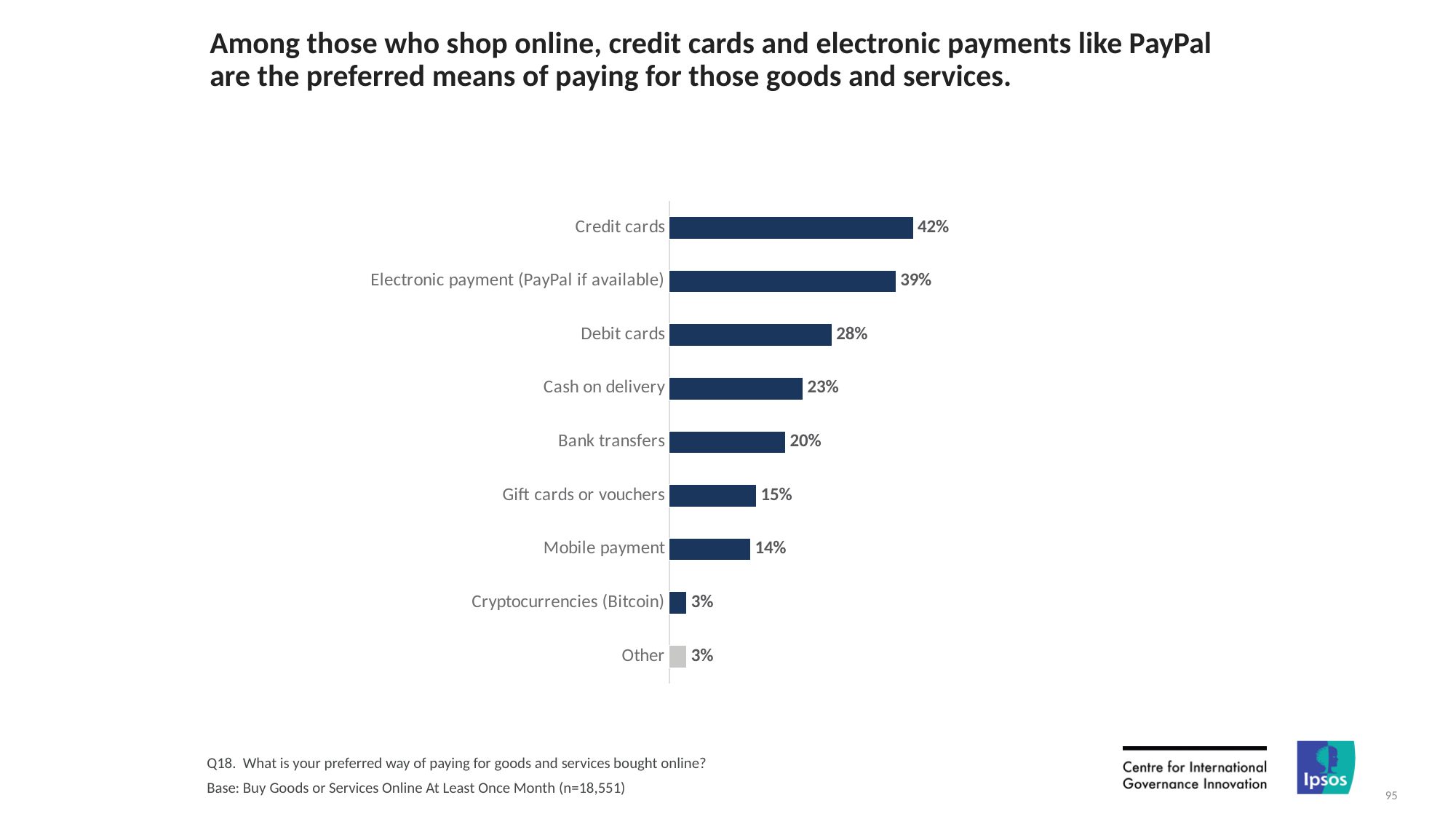
What is the difference between the values for Credit cards and Debit cards? 14% What percentage of online shoppers prefer credit cards as their way of paying? 42% What is the value for Mobile payment? 14% Which payment method has the highest value on the chart? Credit cards What kind of chart is shown on the slide? Bar chart Which category's bar is shown in grey rather than dark blue? Other What value is shown for Cryptocurrencies (Bitcoin)? 3% What is the value shown for Electronic payment (PayPal if available)? 39% How many payment method categories are shown on the chart? 9 What percentage is shown for Cash on delivery? 23% Which is larger, the value for Debit cards or the value for Cash on delivery? Debit cards What is the difference between Bank transfers and Gift cards or vouchers? 5%